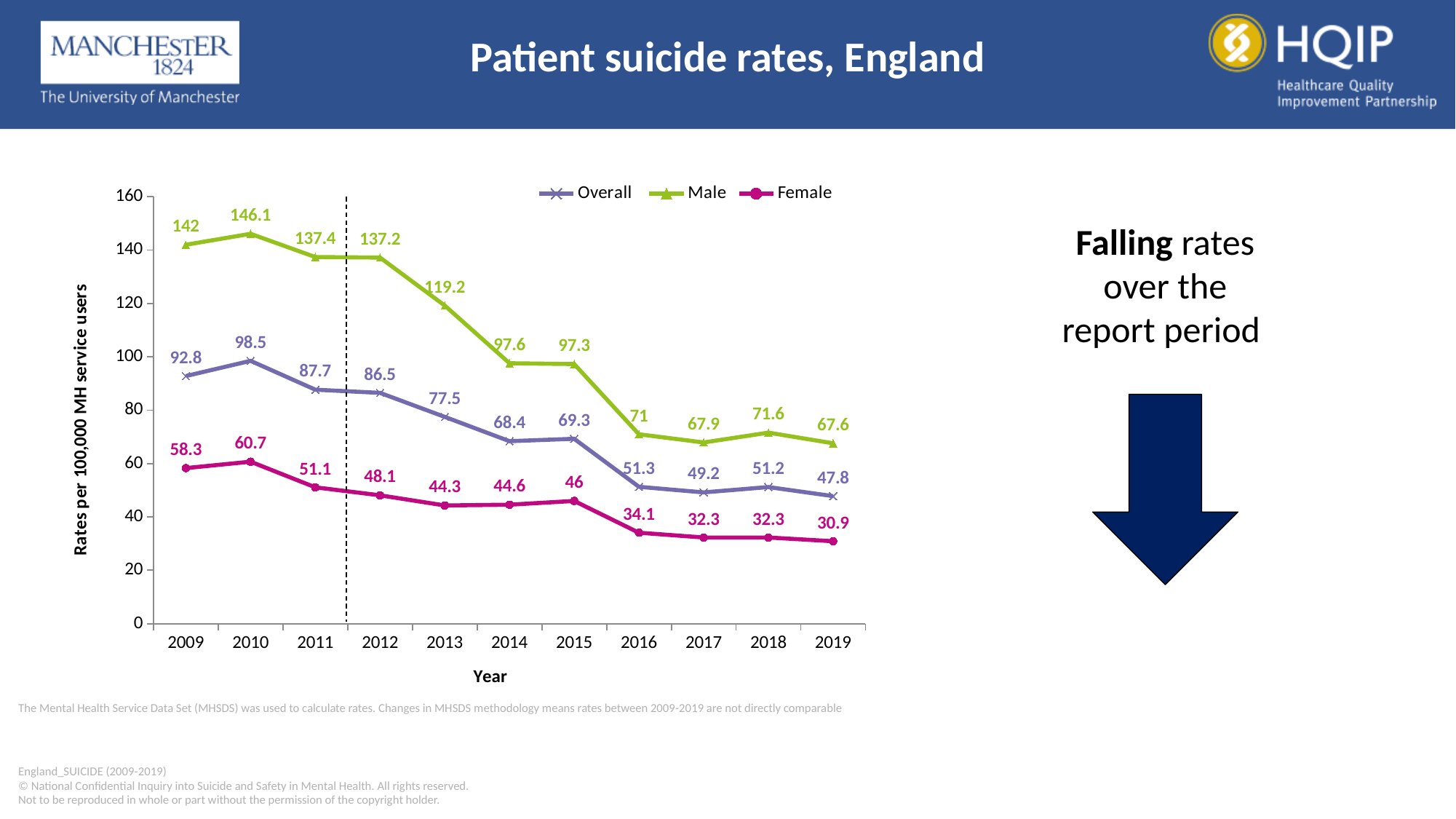
What is the Female rate in 2019? 30.9 In which year is the Female rate lowest? 2019 How many series does the legend list? 3 Does the Overall rate generally rise or fall from 2010 to 2019? fall What is the difference between the Male and Female rates in 2009? 83.7 What is the Male rate in 2010? 146.1 Which is larger, the Overall rate in 2016 or the Overall rate in 2018? 2016 Is the Male rate in 2014 greater or less than 100? less How many years are shown on the x axis? 11 In which year is the Male rate highest? 2010 What is the Overall rate in 2013? 77.5 What kind of chart is shown? line chart